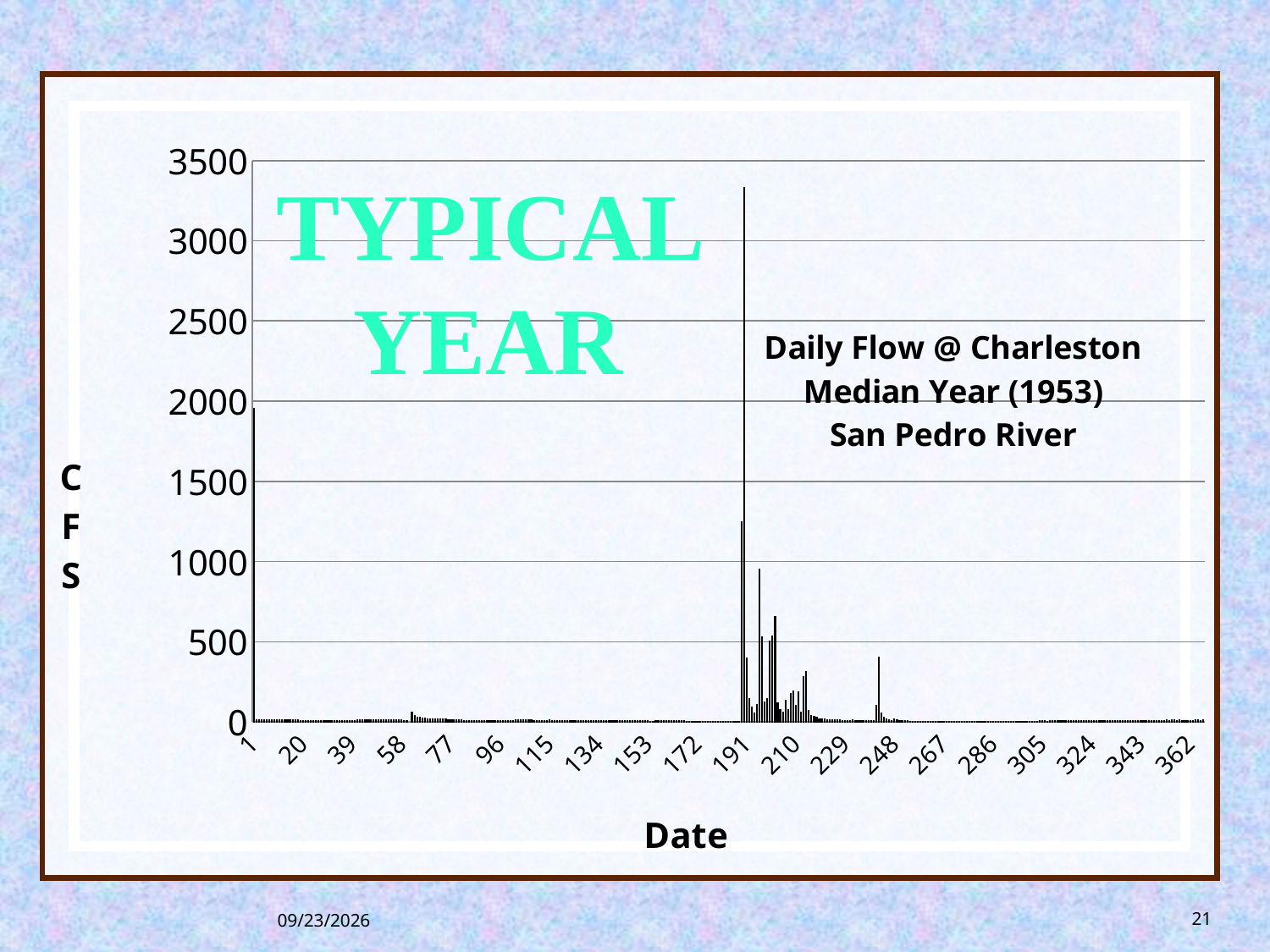
Is the value for the first day (x-axis tick 1) greater or less than 1500 CFS? greater What label is shown on the vertical axis of the chart? CFS Is the value near x-axis tick 248 greater or less than 500 CFS? less What is the title of the chart? Daily Flow @ Charleston Median Year (1953) San Pedro River Is the value for the first day (x-axis tick 1) greater or less than 2500 CFS? less What is the highest value shown on the vertical axis? 3500 What is the last labelled tick on the x axis? 362 Which is larger: the tallest bar near x-axis tick 191 or the bar at x-axis tick 1? the bar near 191 Near which labelled x-axis tick does the tallest bar of the chart occur? 191 What kind of chart is shown on the slide? bar chart